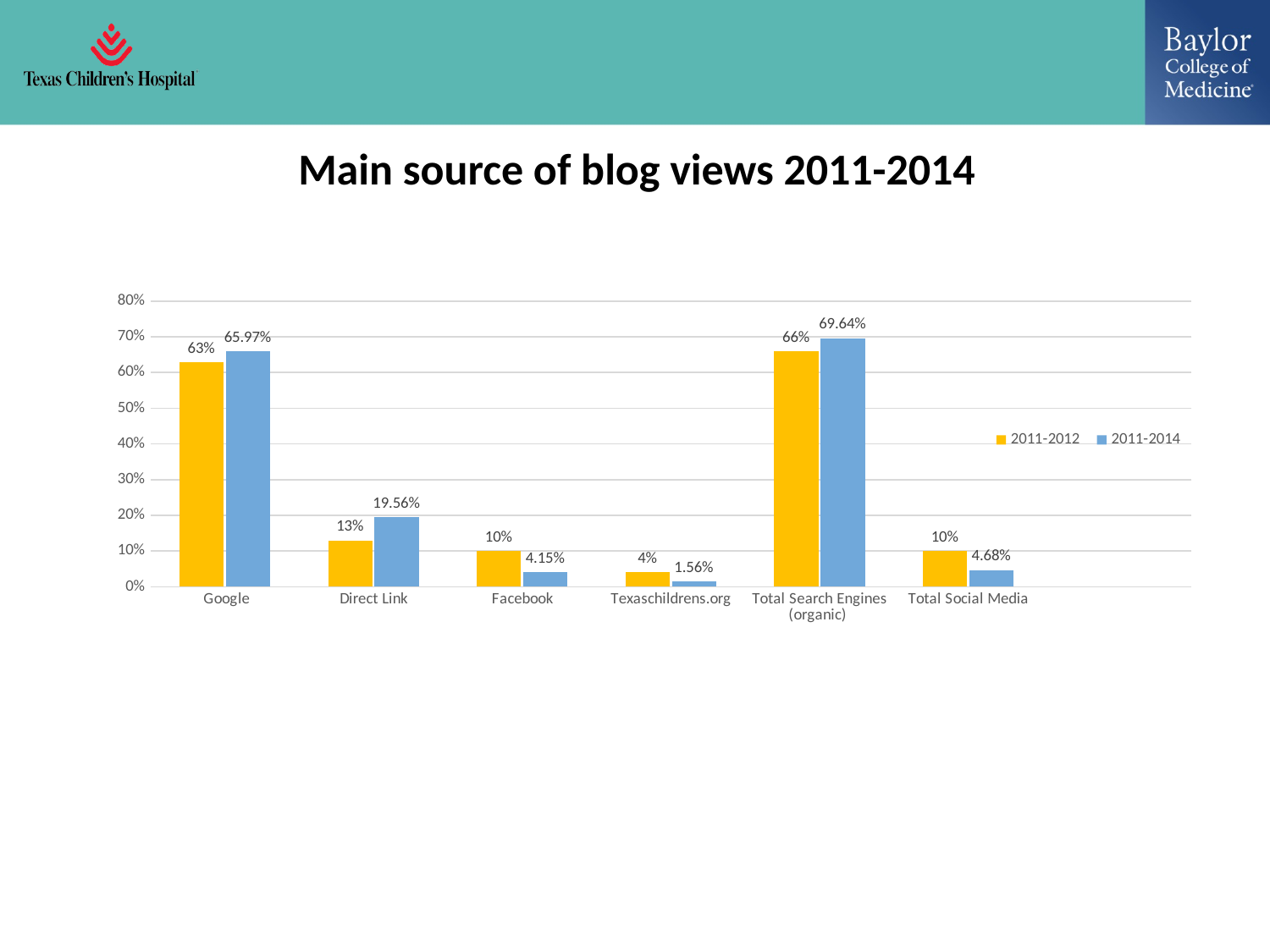
How many series does the legend list? 2 How many categories are shown on the x axis? 6 What is the 2011-2012 value for Direct Link? 13% Which is larger for Facebook: the 2011-2012 value or the 2011-2014 value? 2011-2012 What kind of chart is shown on the slide? Bar chart Which category has the highest 2011-2014 value? Total Search Engines (organic) What is the 2011-2014 value for Google? 65.97% What is the title of the chart? Main source of blog views 2011-2014 What is the 2011-2014 value for Facebook? 4.15% What is the difference between the 2011-2014 and 2011-2012 values for Direct Link? 6.56% Which category has the lowest 2011-2012 value? Texaschildrens.org What is the 2011-2014 value for Texaschildrens.org? 1.56%